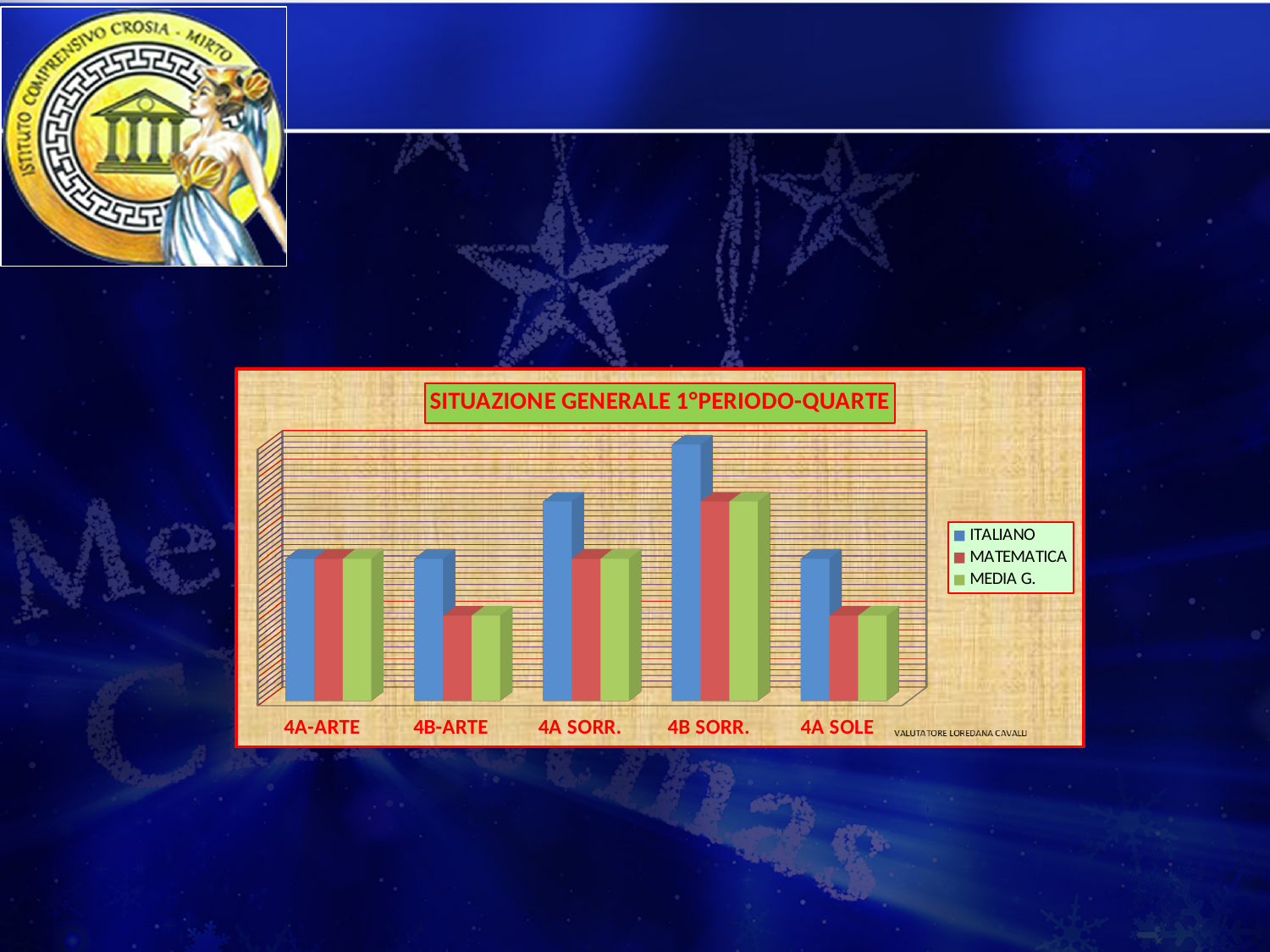
How many categories are shown along the x axis of the chart? 5 What kind of chart is shown on the slide? Bar chart Which has the larger ITALIANO value: 4A-ARTE or 4A SORR.? 4A SORR. Which has the larger MATEMATICA value: 4A SOLE or 4B SORR.? 4B SORR. Which category has the highest ITALIANO value? 4B SORR. Which category has the highest MEDIA G. value? 4B SORR. For 4A SORR., which is larger: the ITALIANO value or the MEDIA G. value? ITALIANO What is the title of the chart? SITUAZIONE GENERALE 1°PERIODO-QUARTE Which series is shown in blue in the chart? ITALIANO How many series does the chart's legend list? 3 Which category has the highest MATEMATICA value? 4B SORR.